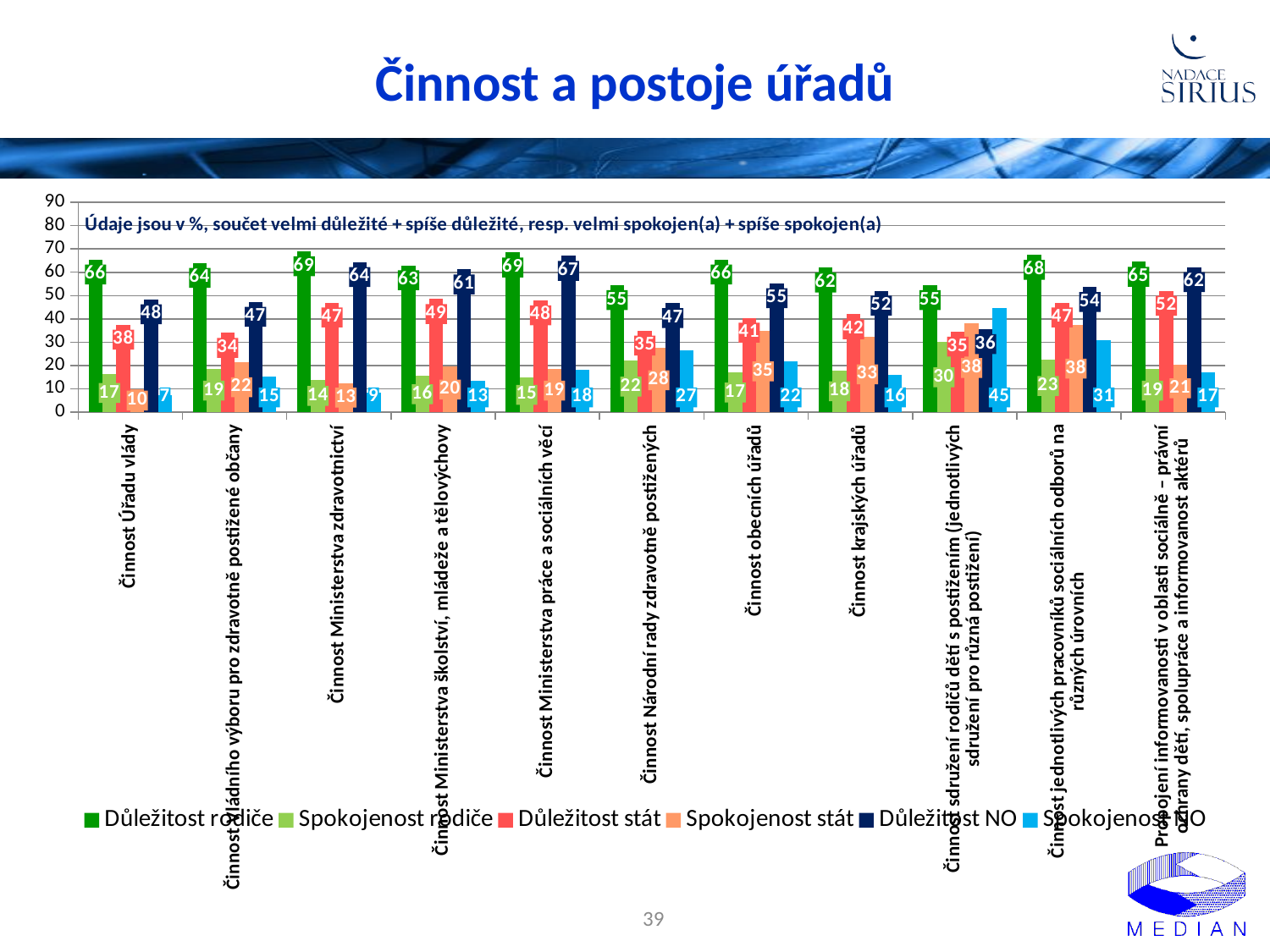
What is the value of Spokojenost NO for Činnost sdružení rodičů dětí s postižením (jednotlivých sdružení pro různá postižení)? 45 Which category has the highest value for Spokojenost NO? Činnost sdružení rodičů dětí s postižením (jednotlivých sdružení pro různá postižení) Which is larger: Důležitost NO for Činnost Ministerstva zdravotnictví or Důležitost NO for Činnost Úřadu vlády? Činnost Ministerstva zdravotnictví What is the value of Spokojenost stát for Činnost obecních úřadů? 35 What is the difference between Důležitost rodiče and Spokojenost rodiče for Činnost Úřadu vlády? 49 Which category has the lowest value for Spokojenost NO? Činnost Úřadu vlády How many categories are shown on the x axis? 11 What is the title of the slide? Činnost a postoje úřadů What kind of chart is shown on the slide? Bar chart How many series does the legend list? 6 What is the value of Důležitost rodiče for Činnost Úřadu vlády? 66 What is the difference between Důležitost NO and Spokojenost NO for Činnost Ministerstva práce a sociálních věcí? 49